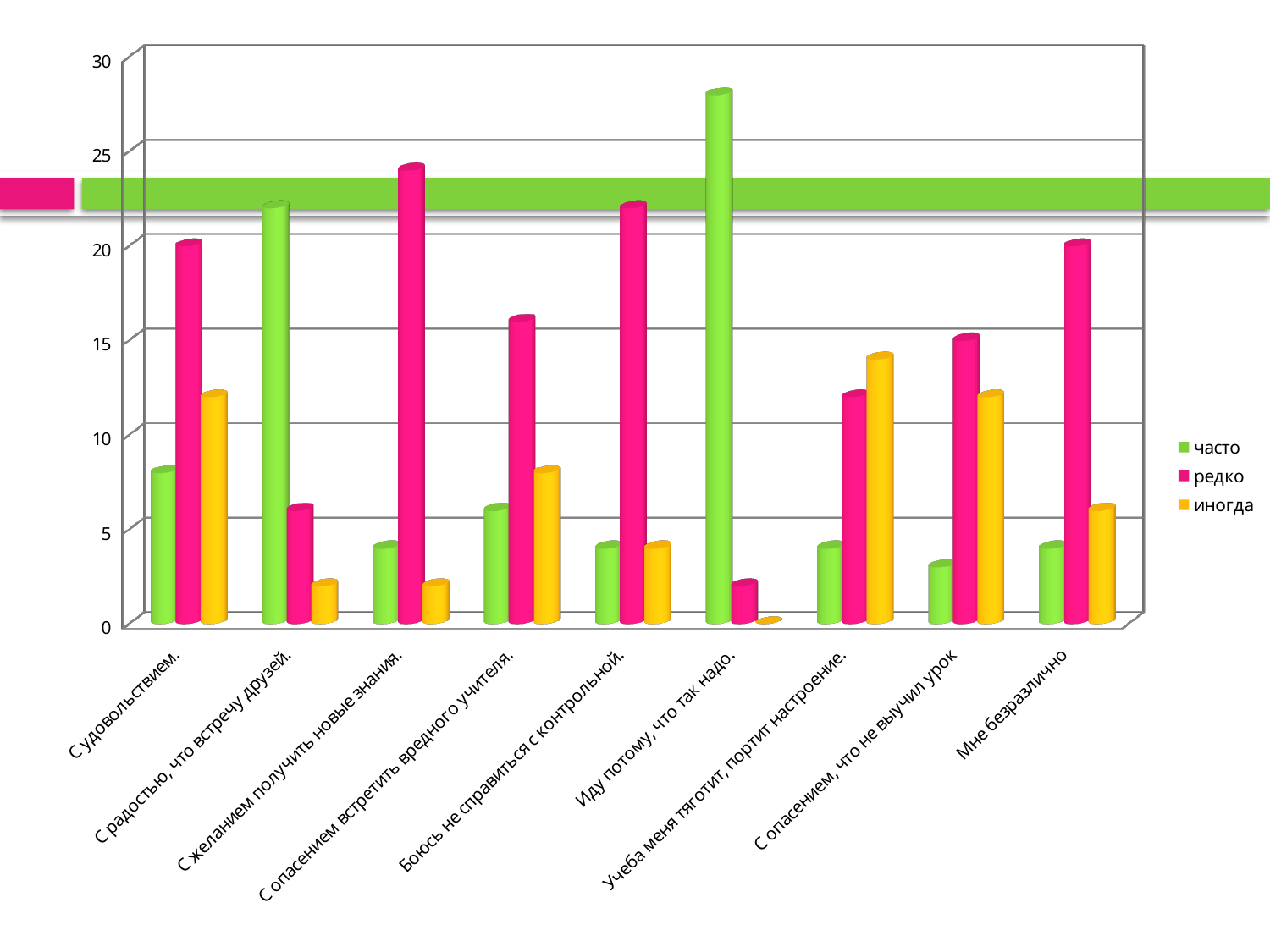
Is the value of 'иногда' for 'Учеба меня тяготит, портит настроение.' greater or less than 10? greater How many series does the legend list? 3 Which category has the highest value for the series 'иногда'? Учеба меня тяготит, портит настроение. How many categories are shown along the x axis? 9 Which category has the highest value for the series 'редко'? С желанием получить новые знания. For 'Мне безразлично', which series has the larger value, 'редко' or 'иногда'? редко Which category has the highest value for the series 'часто'? Иду потому, что так надо. Which category has the lowest value for the series 'иногда'? Иду потому, что так надо. What kind of chart is shown on the slide? bar chart Is the value of 'редко' for 'С желанием получить новые знания.' greater or less than 20? greater For 'С радостью, что встречу друзей.', which series has the larger value, 'часто' or 'редко'? часто Is the value of 'часто' for 'Иду потому, что так надо.' greater or less than 25? greater